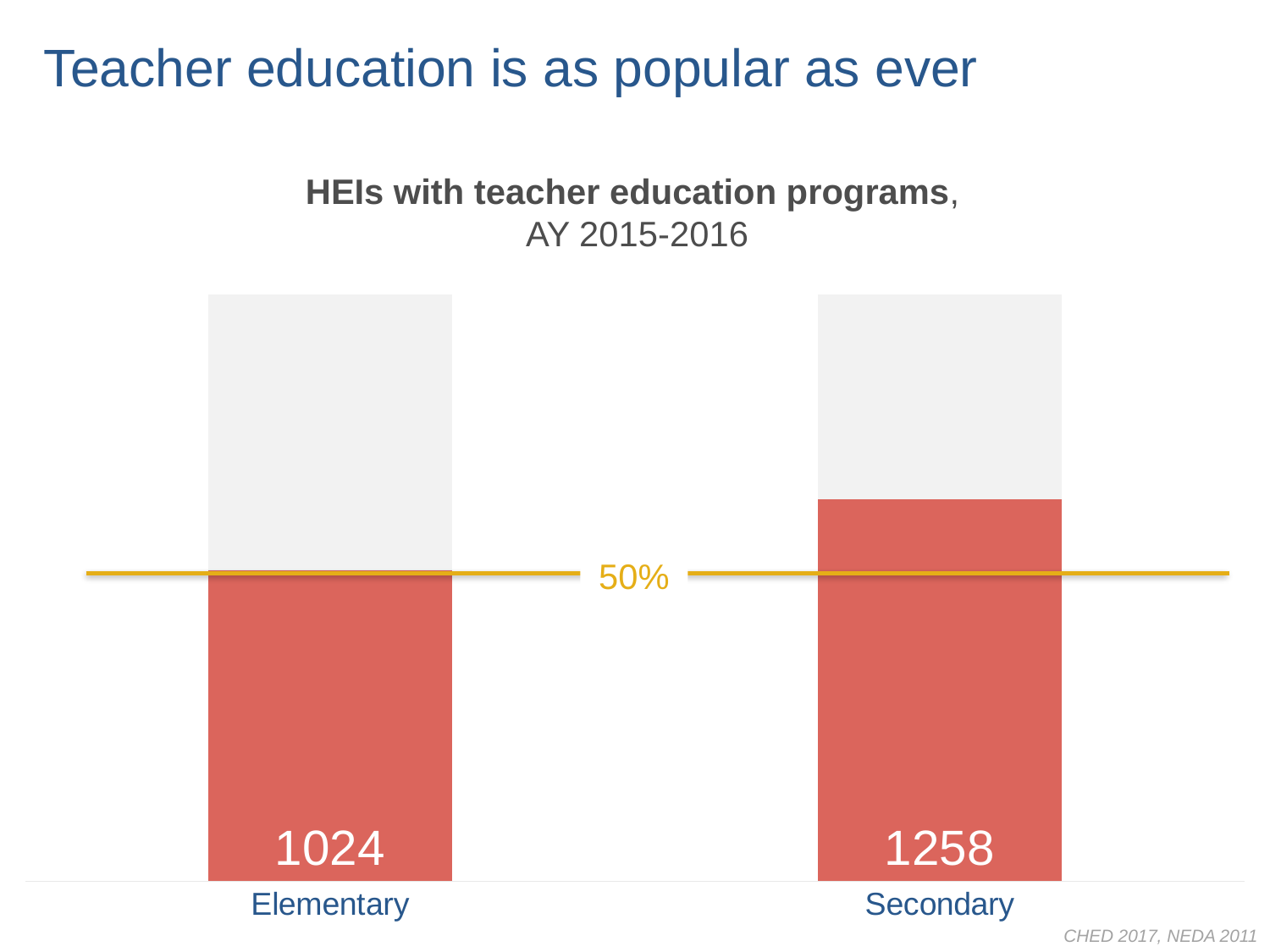
What is the title of the chart? HEIs with teacher education programs, AY 2015-2016 What percentage is marked by the horizontal reference line across the chart? 50% Is the value for Secondary larger or smaller than the value for Elementary? larger What is the value shown for Elementary? 1024 What is the difference between the Secondary and Elementary values? 234 How many categories are shown on the chart? 2 Which category has the higher value, Elementary or Secondary? Secondary Is the red bar for Secondary above or below the 50% line? above What is the value shown for Secondary? 1258 What kind of chart is shown on the slide? bar chart Which category has the lower value? Elementary